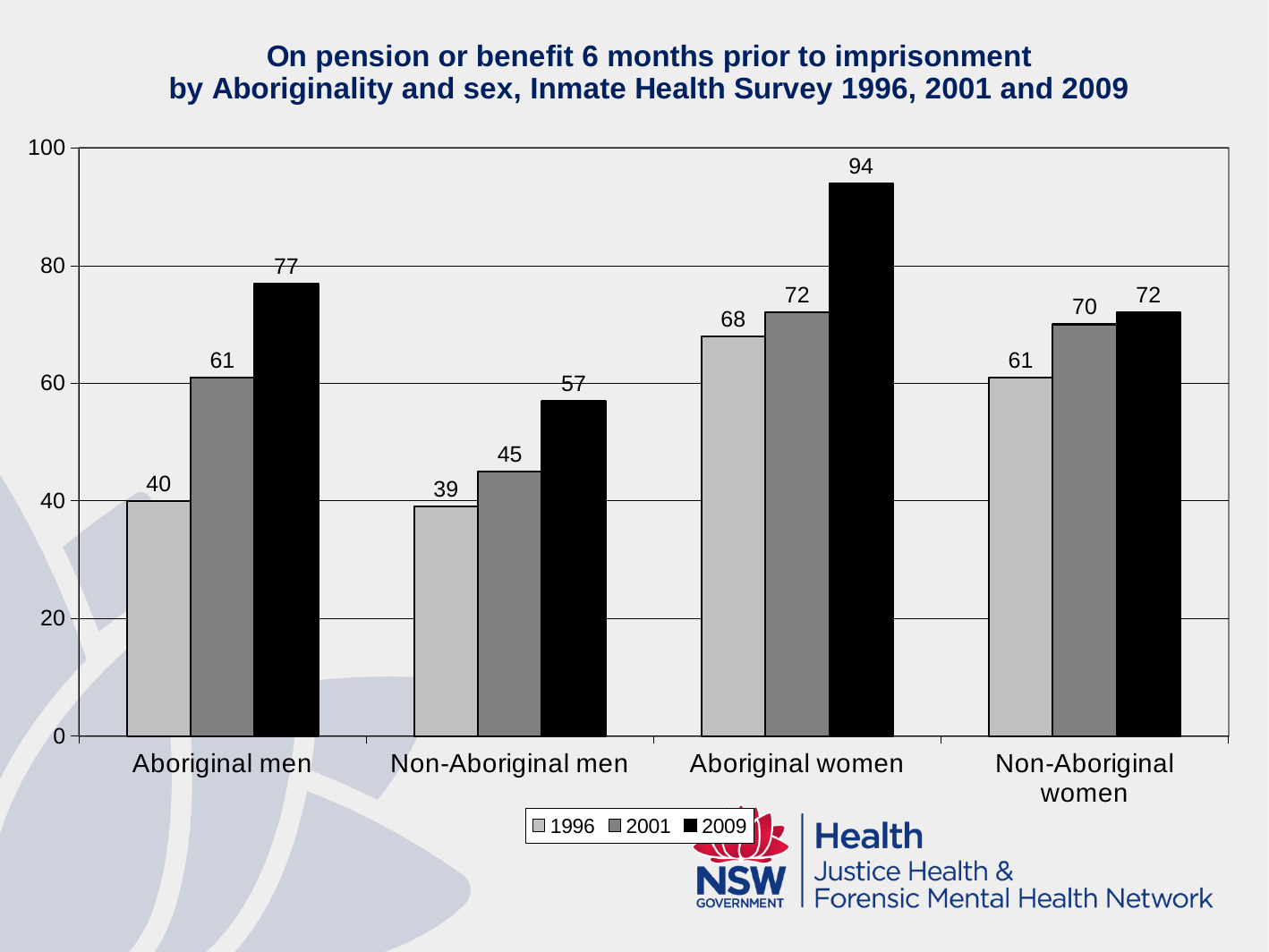
Is the value for Non-Aboriginal men in 2009 greater or less than 60? less Which is larger: the 2001 value for Aboriginal men or the 2001 value for Non-Aboriginal women? Non-Aboriginal women What is the value for Aboriginal women in 2001? 72 What is the difference between the 2009 and 1996 values for Aboriginal men? 37 How many categories are shown on the x axis? 4 How many series does the legend list? 3 What is the value for Aboriginal men in 2009? 77 What kind of chart is shown on the slide? bar chart Which category has the highest value in 2009? Aboriginal women What is the value for Non-Aboriginal women in 1996? 61 For Non-Aboriginal men, do the values rise or fall from 1996 to 2009? rise Which category has the lowest value in 1996? Non-Aboriginal men